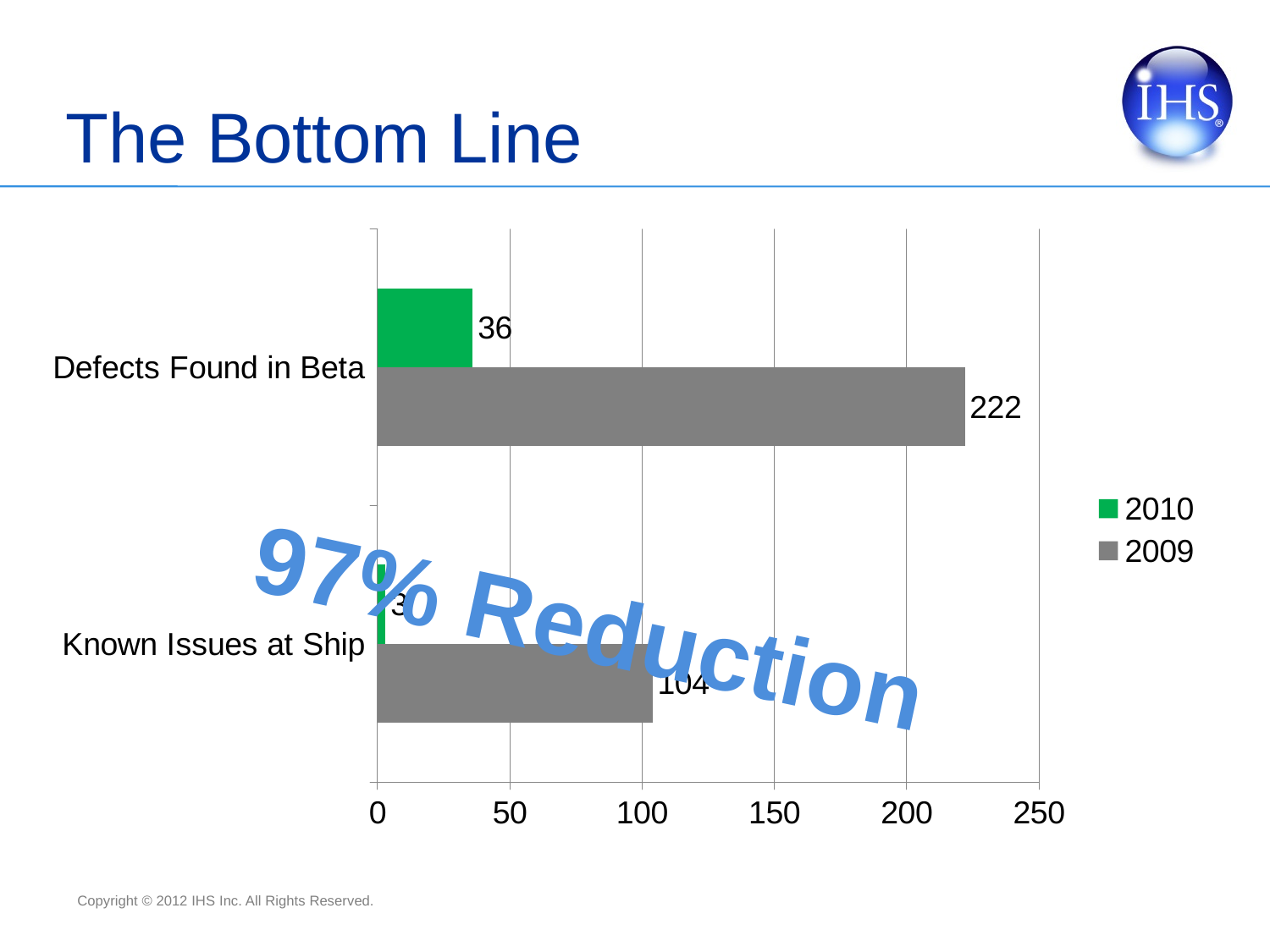
Which colour represents the 2010 series in the legend? green What is the 2009 value for Known Issues at Ship? 104 What is the 2010 value for Defects Found in Beta? 36 What is the difference between the 2009 and 2010 values for Defects Found in Beta? 186 What kind of chart is shown on the slide? bar chart How many categories are shown on the chart? 2 Which is larger for Known Issues at Ship, the 2009 value or the 2010 value? 2009 Is the 2009 value for Known Issues at Ship greater or less than 100? greater What is the 2010 value for Known Issues at Ship? 3 Which category has the highest 2009 value? Defects Found in Beta How many series does the legend list? 2 What is the 2009 value for Defects Found in Beta? 222